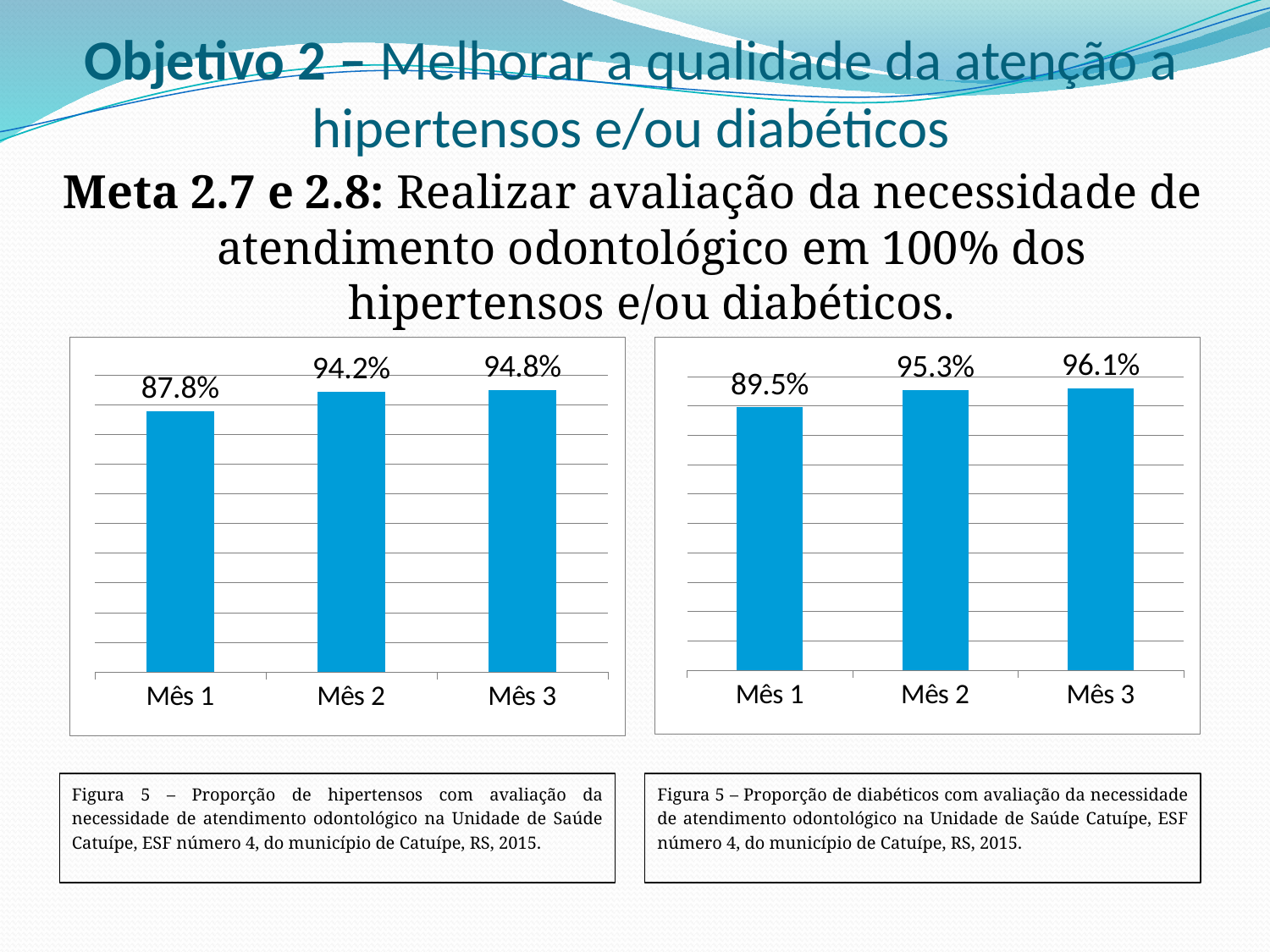
In the right chart (diabéticos), which month has the highest value? Mês 3 How many months are shown in the right chart (diabéticos)? 3 In the left chart (hipertensos), which month has the lowest value? Mês 1 In the left chart (hipertensos), what is the value for Mês 3? 94.8% In the right chart (diabéticos), do the values rise or fall from Mês 1 to Mês 3? Rise In the left chart (hipertensos), what is the value for Mês 1? 87.8% In the left chart (hipertensos), which is larger, the value for Mês 1 or Mês 2? Mês 2 In the right chart (diabéticos), what is the value for Mês 3? 96.1% In the left chart (hipertensos), what is the difference between Mês 2 and Mês 1? 6.4% In the right chart (diabéticos), what is the value for Mês 2? 95.3% In the right chart (diabéticos), what is the difference between Mês 3 and Mês 1? 6.6% What type of chart is the left chart (hipertensos)? Bar chart